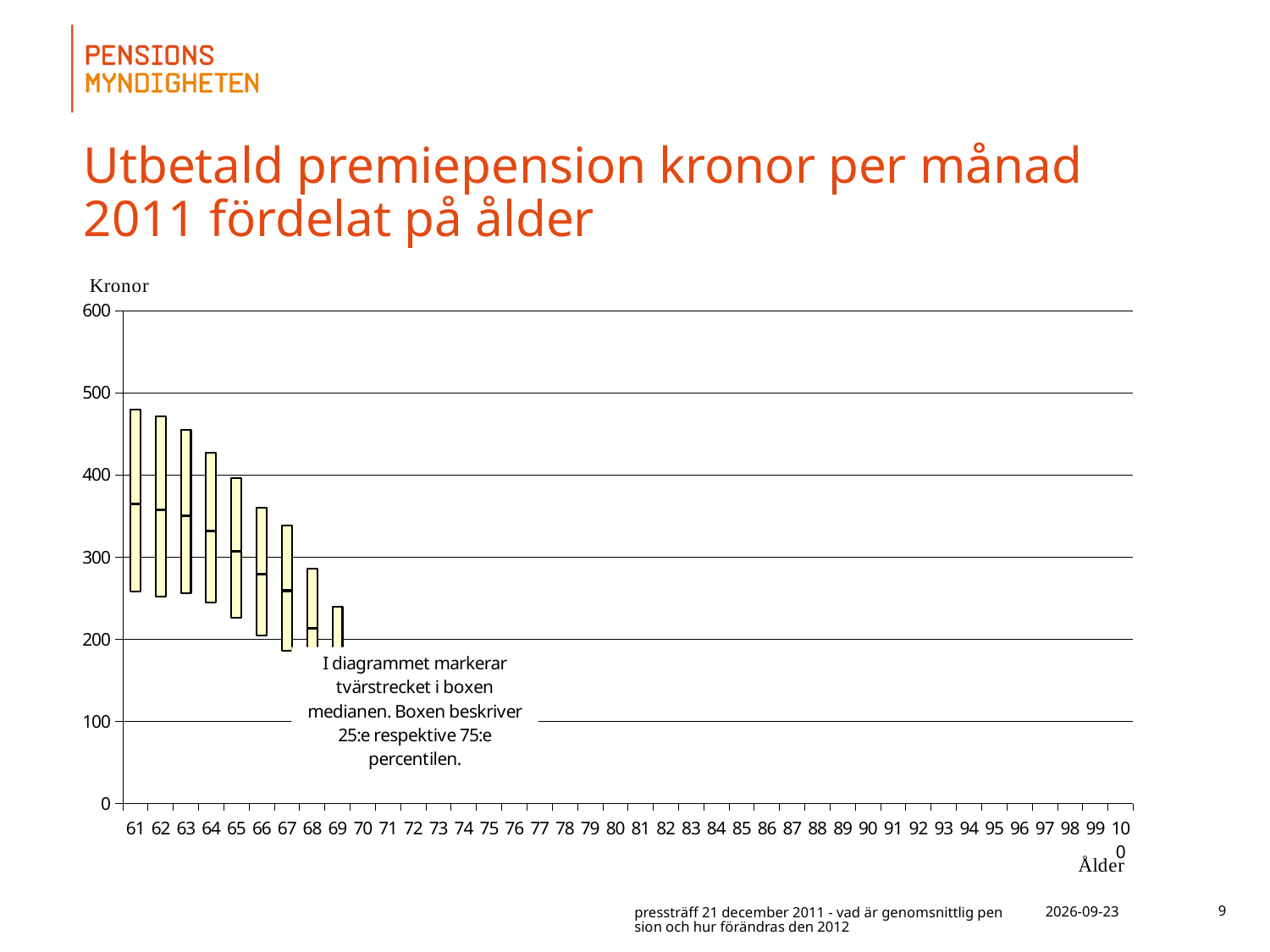
Is the 75th percentile value for age 61 greater or less than 500? less What label is shown on the vertical axis of the chart? Kronor Is the median value for age 61 greater or less than 300? greater Is the 75th percentile value for age 69 greater or less than 200? greater Which age has the lowest median premium pension? 69 Do the median values rise or fall as age increases from 61 to 69? fall Which age has the larger median premium pension, 63 or 67? 63 Which age has the highest median premium pension? 61 For how many ages are boxes plotted in the chart? 9 What kind of chart is shown on the slide? box plot What is the title of the chart on the slide? Utbetald premiepension kronor per månad 2011 fördelat på ålder